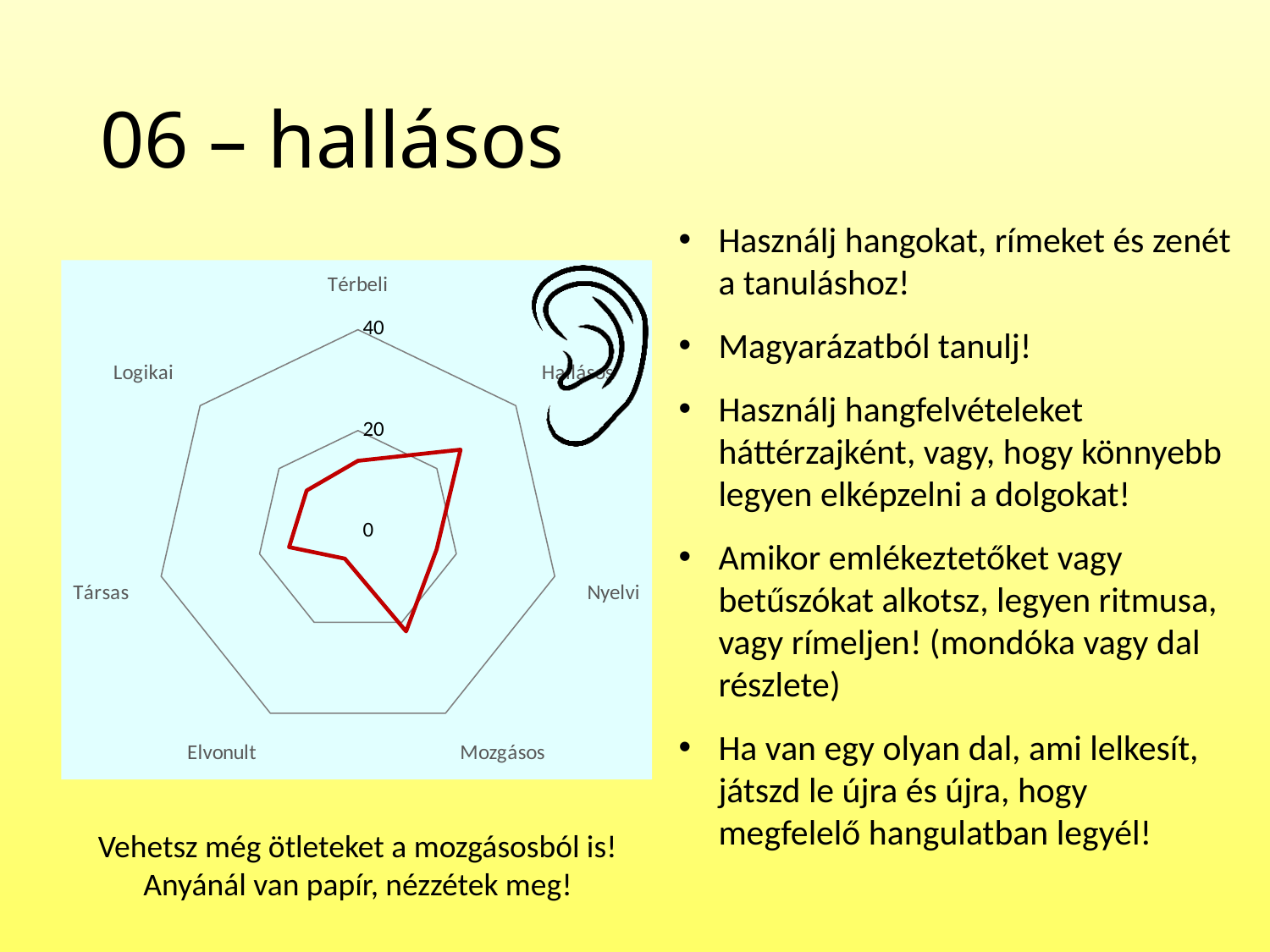
What is the highest tick value shown on the radar chart's axis? 40 Is the value for Hallásos greater or less than 20? greater Which is larger, the value for Hallásos or the value for Nyelvi? Hallásos Is the value for Hallásos greater or less than 40? less Which category has the highest value in the radar chart? Hallásos Is the value for Logikai greater or less than 20? less How many categories (axes) does the radar chart have? 7 Which is larger, the value for Mozgásos or the value for Elvonult? Mozgásos What kind of chart is shown on the slide? radar chart